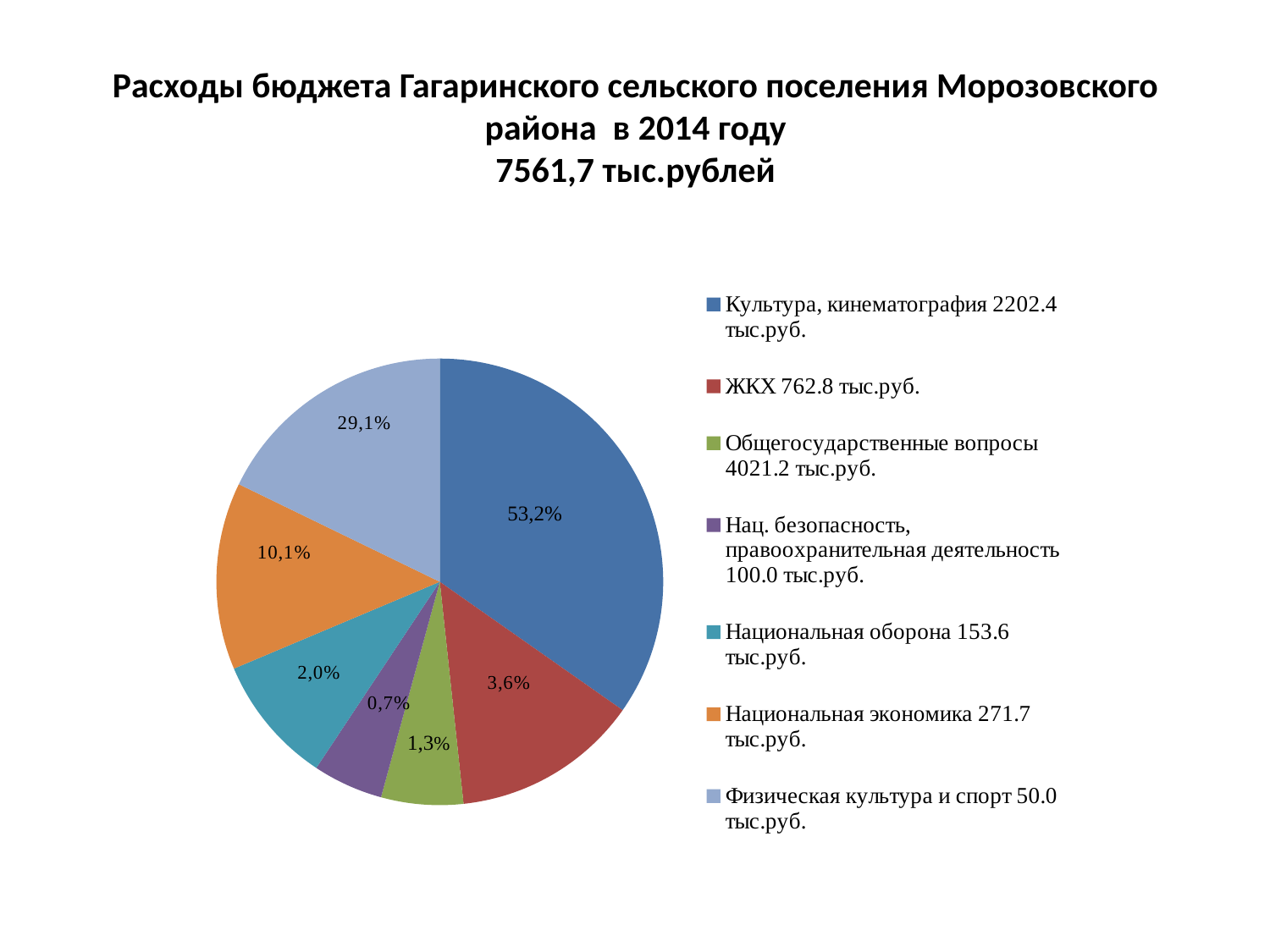
What percentage is shown on the orange slice of the pie chart? 10,1% What is the percentage shown on the smallest slice of the pie chart? 0,7% Which slice is larger: the teal slice (2,0%) or the green slice (1,3%)? the teal slice (2,0%) What kind of chart is shown on the slide? pie chart What is the percentage shown on the largest slice of the pie chart? 53,2% What is the difference in percentage points between the largest slice (53,2%) and the second largest slice (29,1%)? 24,1 What percentage is shown on the light blue slice of the pie chart? 29,1% What total budget expenditure amount is stated in the chart title? 7561,7 тыс.рублей How many entries does the legend of the pie chart list? 7 How many slices does the pie chart have? 7 What percentage is shown on the red slice of the pie chart? 3,6% According to the legend, what amount is given for ЖКХ? 762.8 тыс.руб.